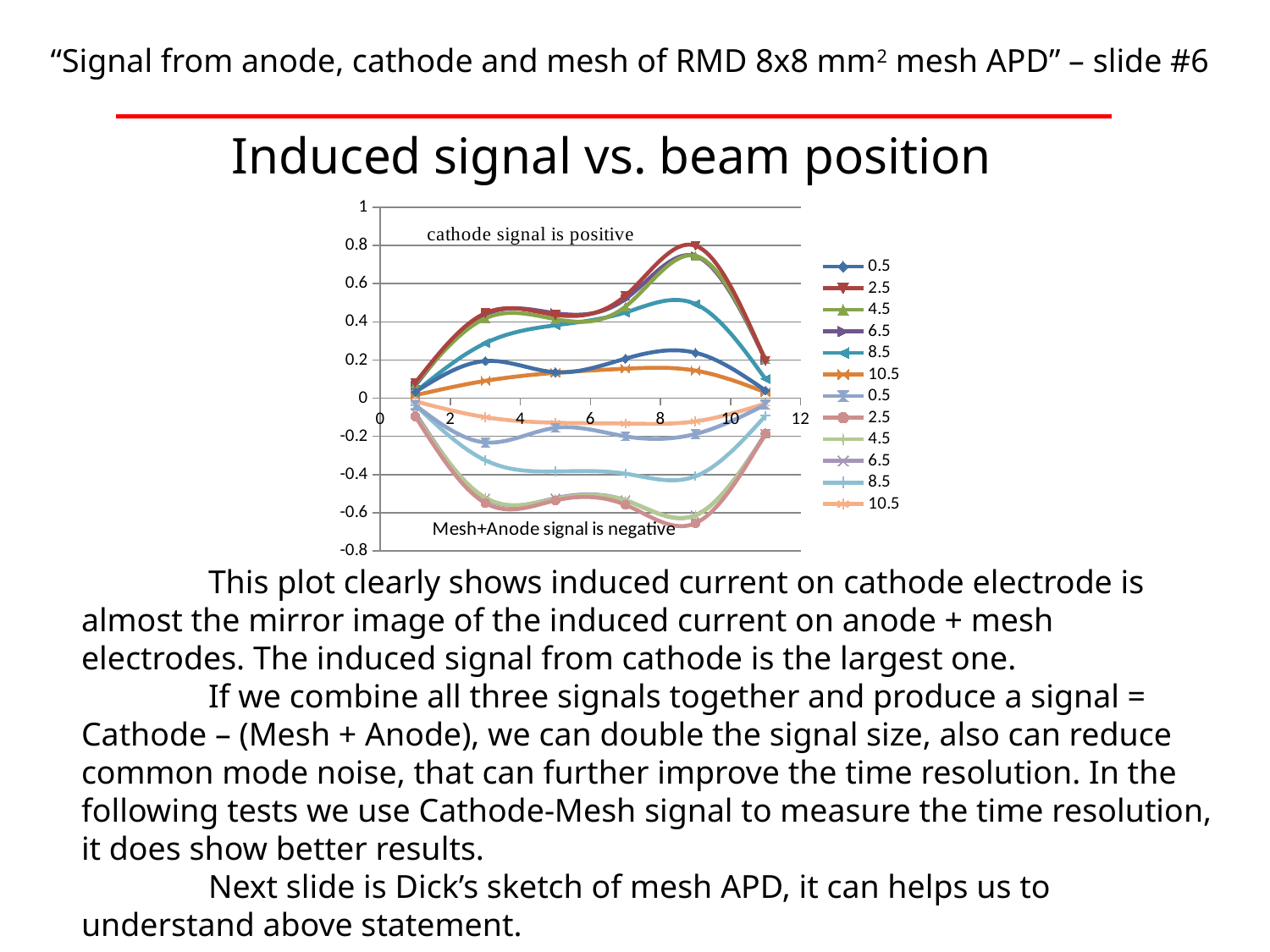
What kind of chart is shown on the slide? line chart Is the value of the lowest curve at x = 2 greater or less than -0.4? greater Is the peak value reached by the highest curve (near x = 9) greater or less than 0.6? greater What annotation is written in the upper part of the plot area, above the positive curves? cathode signal is positive Is the lowest point of the bottom curve (near x = 9) greater or less than -0.4? less Do the positive curves rise or fall between x = 10 and x = 11? fall How many series does the legend of the chart list? 12 What is the title of the chart? Induced signal vs. beam position Are the curves in the upper half of the chart (above zero) positive or negative in value? positive